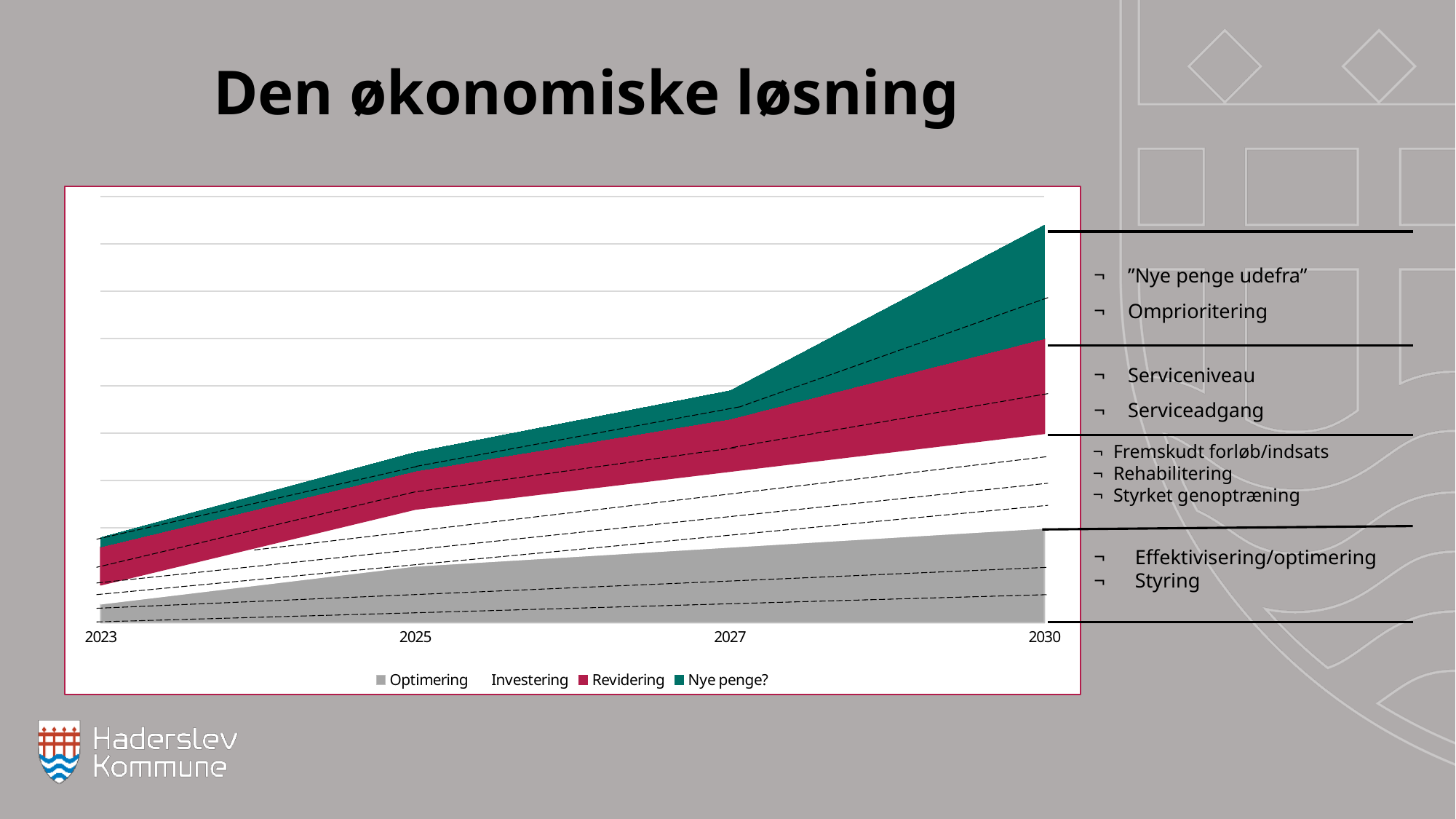
What is the last year shown on the x axis? 2030 Does the total height of the stacked areas rise or fall from 2023 to 2030? Rise How many years are labelled on the x axis of the chart? 4 What kind of chart is shown on the slide? Stacked area chart Does the Nye penge? area get larger or smaller between 2027 and 2030? Larger What colour is the Nye penge? series in the chart? Green How many series does the chart's legend list? 4 What is the first year shown on the x axis? 2023 Does the Optimering area rise or fall from 2023 to 2030? Rise Which series is listed first in the chart's legend? Optimering